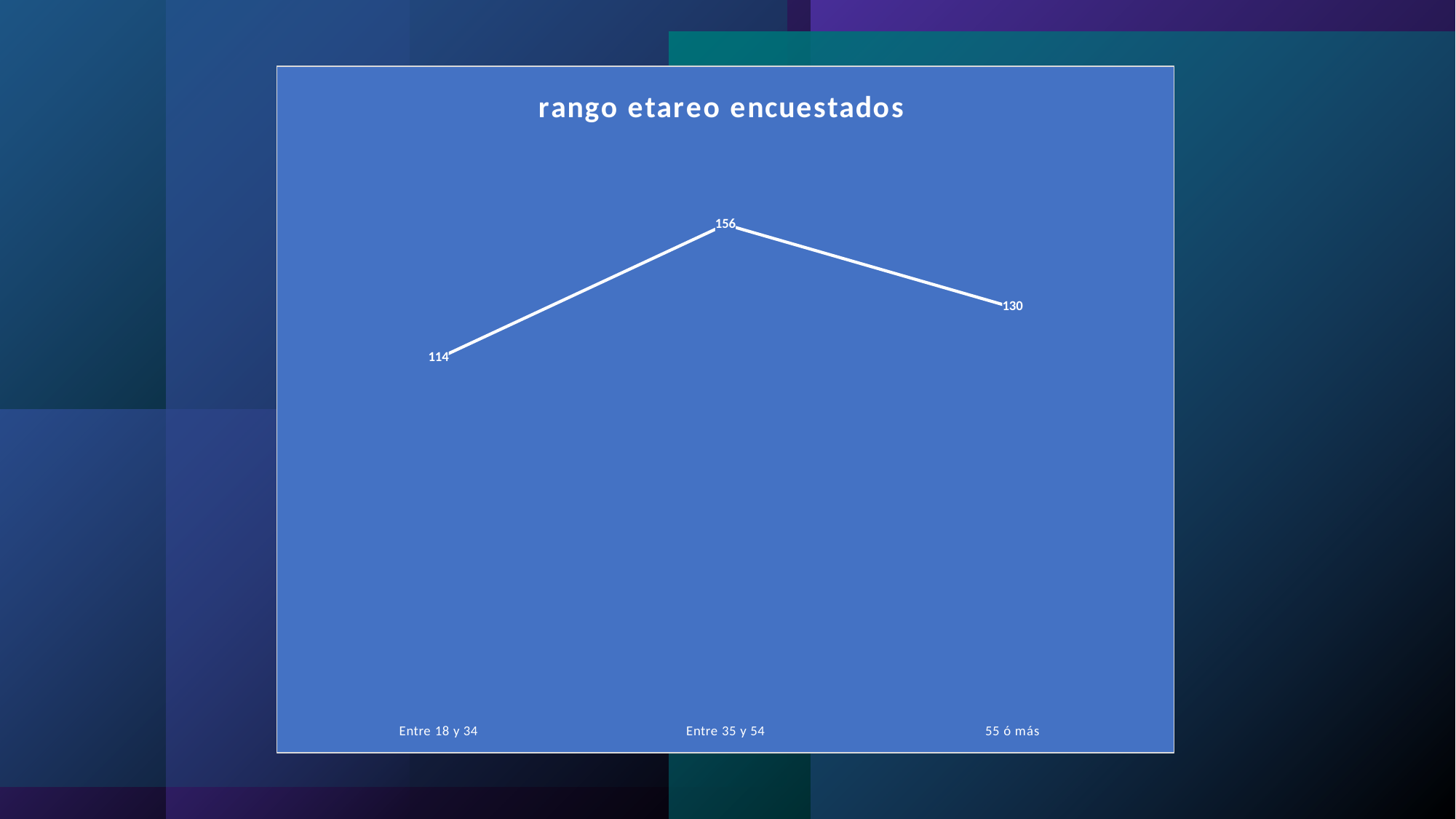
What is the value for Entre 35 y 54? 156 How many age ranges are plotted on the chart? 3 What is the value for Entre 18 y 34? 114 Which age range has the highest value? Entre 35 y 54 Does the line rise or fall from Entre 35 y 54 to 55 ó más? fall What is the value for 55 ó más? 130 What is the difference between the values for Entre 35 y 54 and Entre 18 y 34? 42 What is the difference between the values for 55 ó más and Entre 18 y 34? 16 Which age range has the lowest value? Entre 18 y 34 What is the title of the chart? rango etareo encuestados What kind of chart is shown on the slide? line chart Which is larger, the value for 55 ó más or the value for Entre 18 y 34? 55 ó más